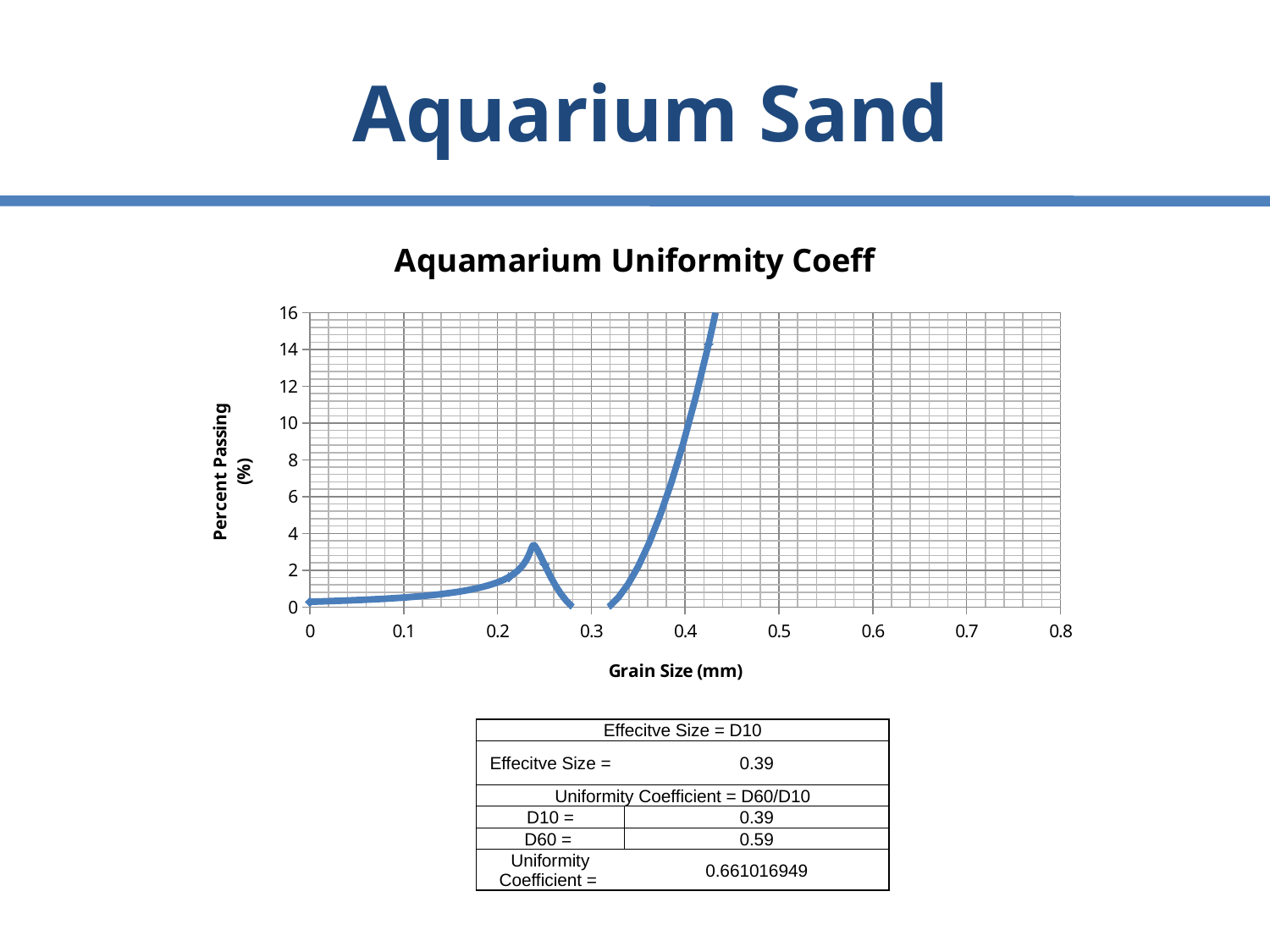
Does the line rise or fall as grain size increases from 0.24 mm to 0.28 mm? fall According to the table below the chart, what is the value of D60? 0.59 According to the table below the chart, what is the Uniformity Coefficient? 0.661016949 Is the percent passing at a grain size of 0.1 mm greater or less than 2? less What is the highest value shown on the x axis of the chart? 0.8 Is the percent passing at a grain size of 0.42 mm greater or less than 10? greater Is the percent passing at a grain size of 0.35 mm greater or less than 6? less What is the label of the x axis of the chart? Grain Size (mm) What kind of chart is shown on the slide? Line chart What is the title of the chart? Aquamarium Uniformity Coeff What is the highest value shown on the y axis of the chart? 16 Does the line rise or fall as grain size increases from 0.32 mm to 0.43 mm? rise